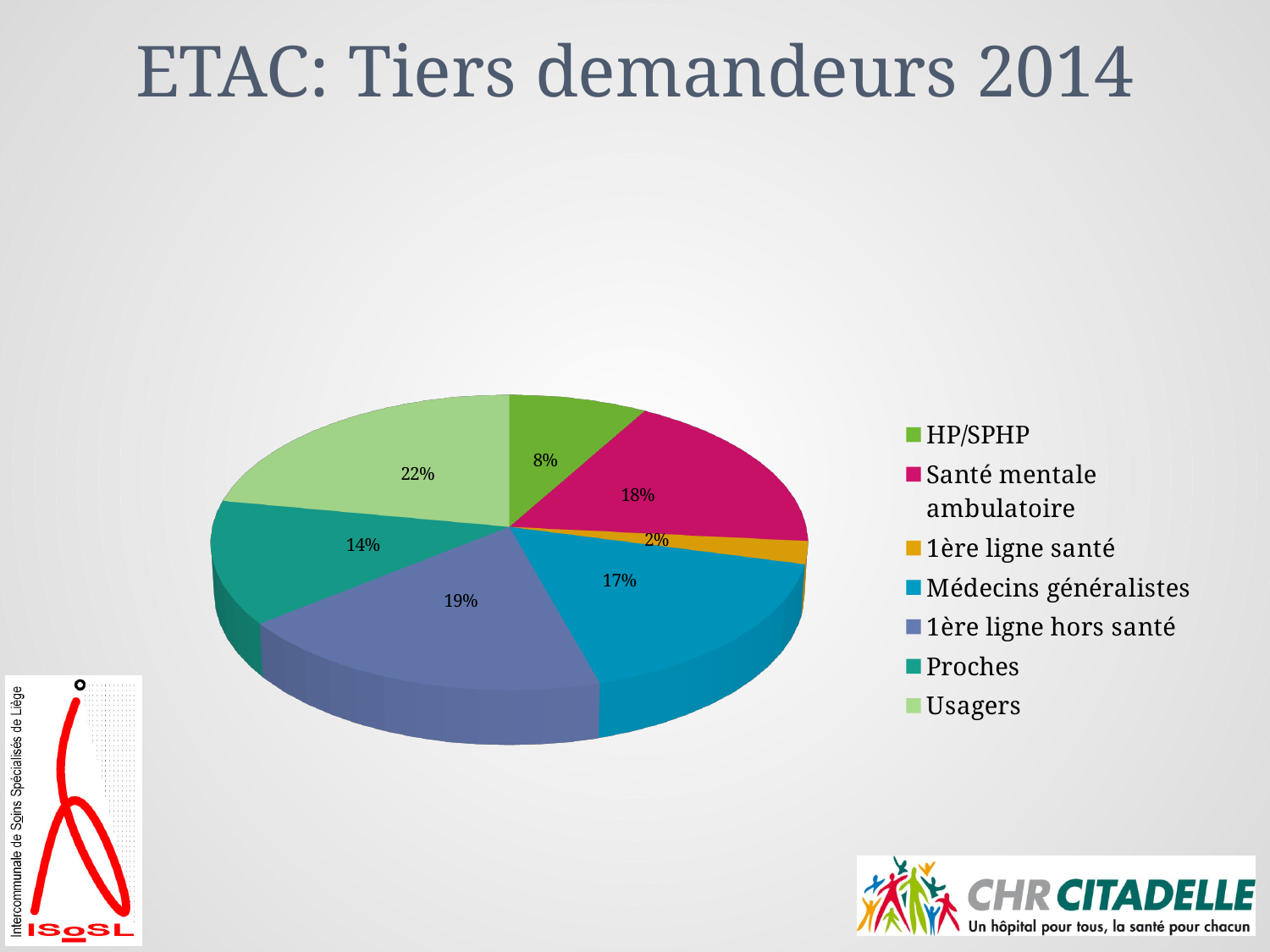
What kind of chart is shown on the slide? Pie chart What percentage is shown for Santé mentale ambulatoire? 18% Which category has the smallest share of the pie? 1ère ligne santé What is the difference in percentage points between Usagers and HP/SPHP? 14 What colour is the Santé mentale ambulatoire slice? Magenta/pink What share of the pie does Usagers represent? 22% What percentage is shown for 1ère ligne hors santé? 19% Which is larger, the share for Proches or the share for 1ère ligne hors santé? 1ère ligne hors santé How many categories does the pie chart show? 7 Which category has the largest share of the pie? Usagers What is the value for Médecins généralistes? 17% What is the title of the slide containing the chart? ETAC: Tiers demandeurs 2014